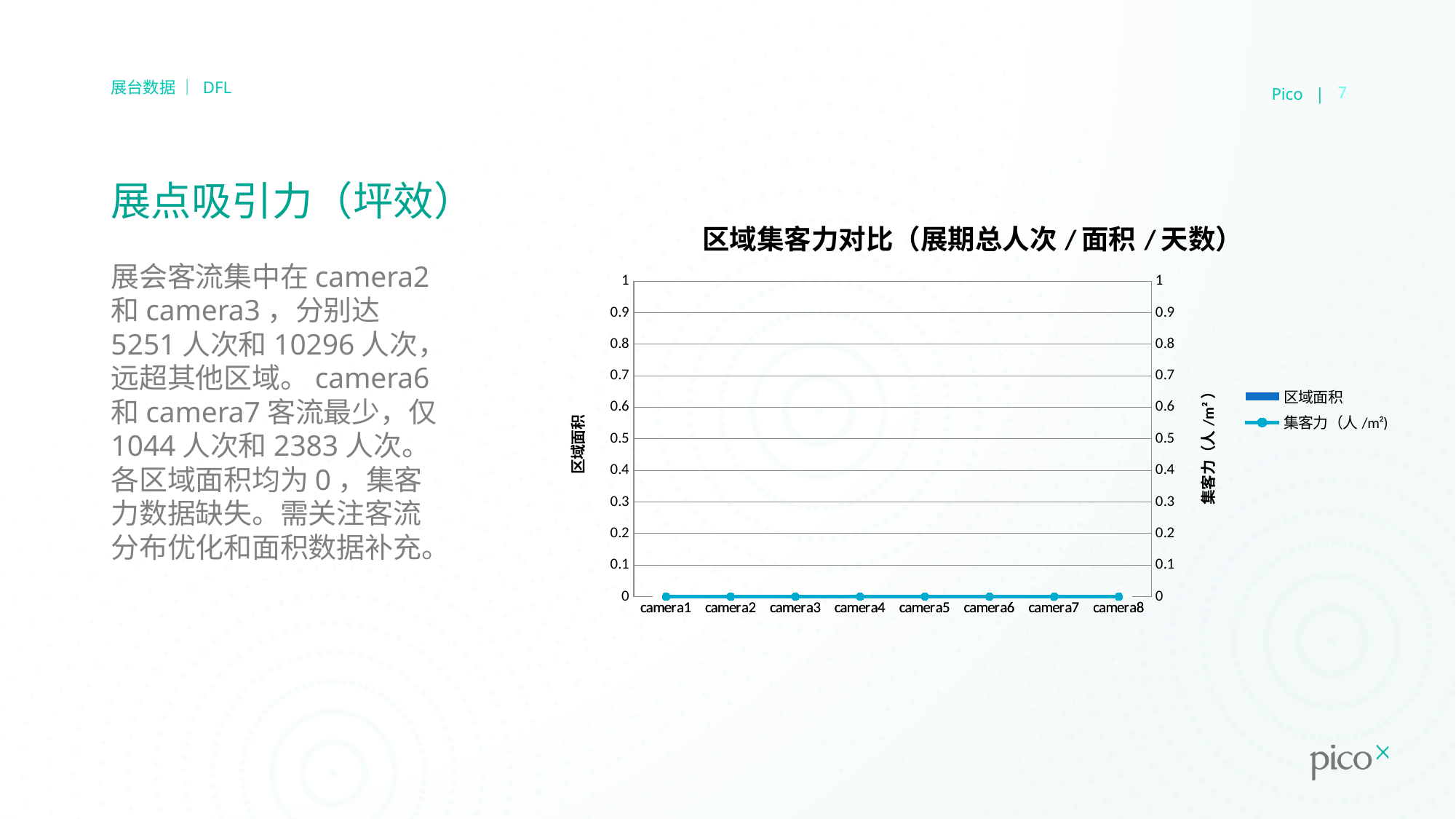
What is the 区域面积 value for camera1 in the chart? 0 What are the two entries listed in the chart's legend? 区域面积 and 集客力（人/m²） What is the 集客力（人/m²） value plotted for camera3? 0 How many camera categories are shown on the x axis of the chart? 8 What is the highest tick value shown on the left vertical axis of the chart? 1 Do the 集客力（人/m²） values rise, fall, or stay flat from camera1 to camera8? stay flat How many series does the chart's legend list? 2 What is the title of the chart? 区域集客力对比（展期总人次 / 面积 / 天数） Is the 集客力（人/m²） value for camera5 greater or less than 0.5? less What is the 集客力（人/m²） value plotted for camera8? 0 Is the 集客力（人/m²） value for camera2 greater or less than 0.1? less